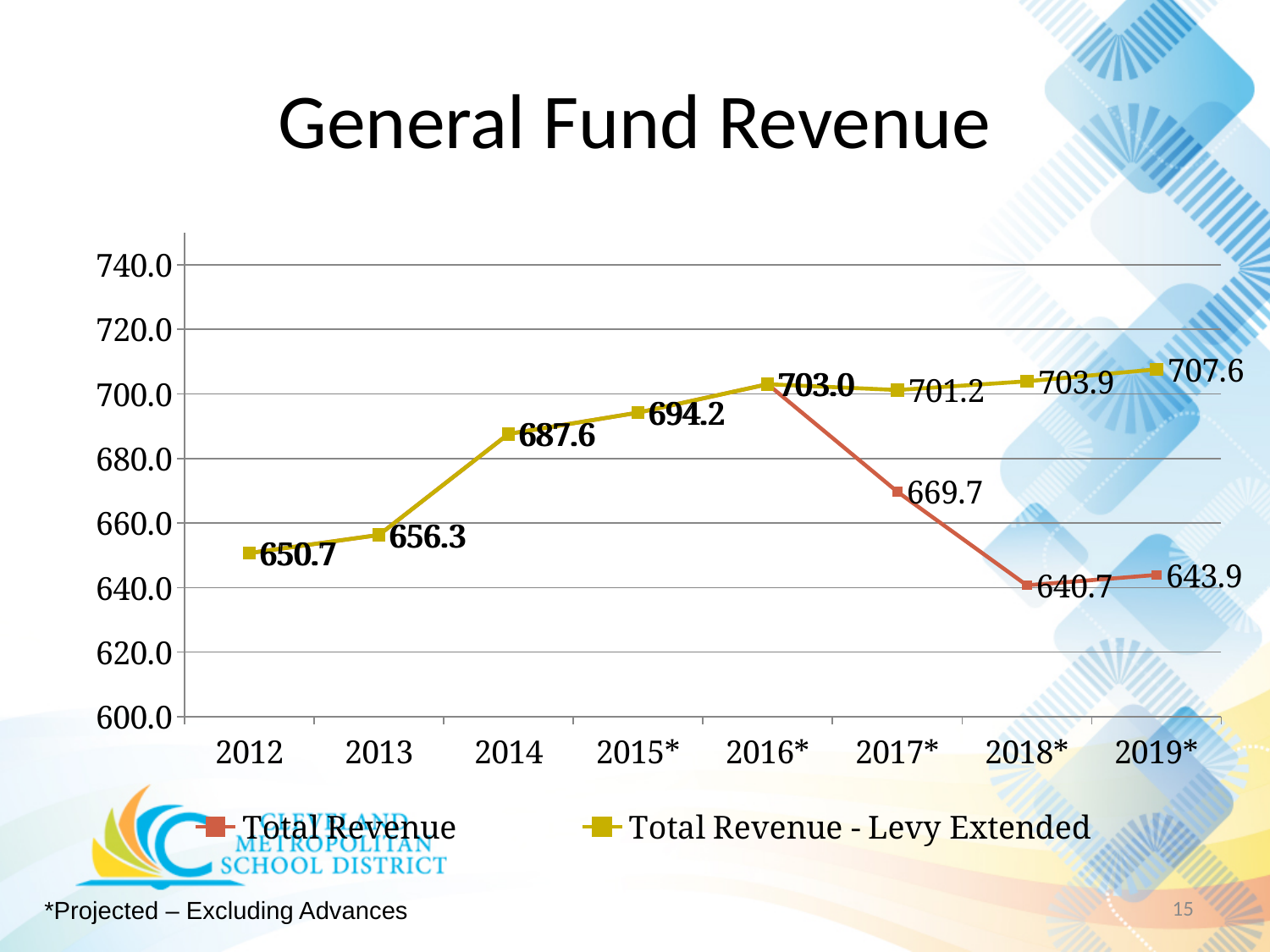
How many series does the legend list? 2 Does the Total Revenue series rise or fall from 2016* to 2018*? Fall What kind of chart is shown on the slide? Line chart Which year has the highest value for Total Revenue - Levy Extended? 2019* What is the value for Total Revenue in 2017*? 669.7 Which is larger in 2018*: Total Revenue or Total Revenue - Levy Extended? Total Revenue - Levy Extended What is the difference between Total Revenue - Levy Extended and Total Revenue in 2019*? 63.7 Which year has the lowest value for Total Revenue - Levy Extended? 2012 What is the value shown for 2014? 687.6 How many years are shown on the x axis? 8 What is the value for Total Revenue - Levy Extended in 2019*? 707.6 What is the value for Total Revenue in 2018*? 640.7